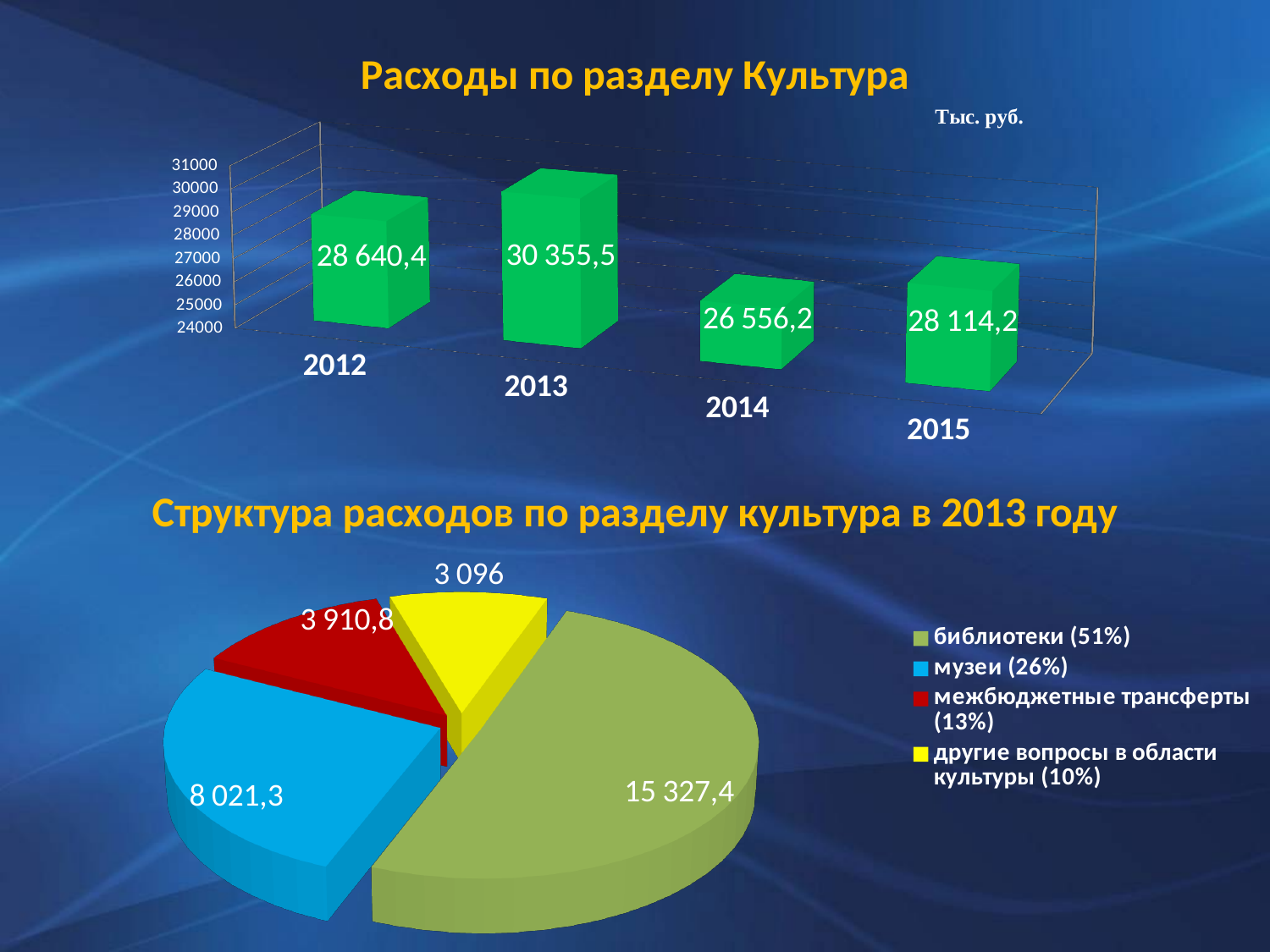
What type of chart is the top chart 'Расходы по разделу Культура'? bar chart In the bar chart 'Расходы по разделу Культура', which year has the highest value? 2013 In the bar chart 'Расходы по разделу Культура', what is the difference between the 2013 and 2012 values? 1 715,1 In the pie chart 'Структура расходов по разделу культура в 2013 году', what is the difference between the библиотеки and музеи values? 7 306,1 In the pie chart 'Структура расходов по разделу культура в 2013 году', what is the value for музеи? 8 021,3 In the bar chart 'Расходы по разделу Культура', which year has the lowest value? 2014 In the pie chart 'Структура расходов по разделу культура в 2013 году', what share of the pie do библиотеки make up? 51% In the bar chart 'Расходы по разделу Культура', how many years are shown? 4 In the pie chart 'Структура расходов по разделу культура в 2013 году', which category has the smallest slice? другие вопросы в области культуры In the bar chart 'Расходы по разделу Культура', which is larger, the value for 2012 or the value for 2015? 2012 In the bar chart 'Расходы по разделу Культура', what is the value for 2014? 26 556,2 In the bar chart 'Расходы по разделу Культура', what is the value for 2013? 30 355,5